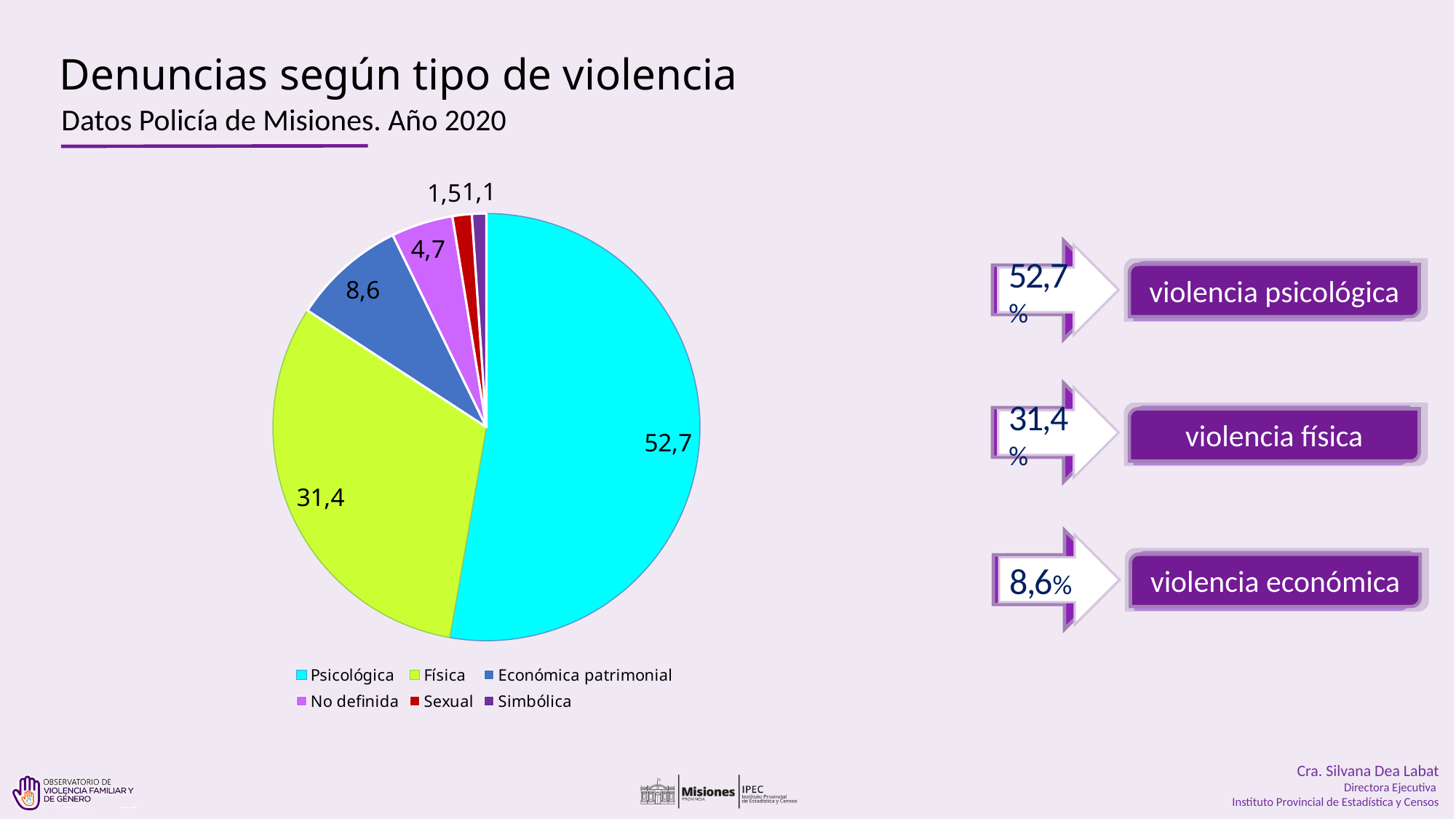
What is the value shown for No definida in the pie chart? 4,7 What is the value shown for Económica patrimonial in the pie chart? 8,6 How many categories does the pie chart legend list? 6 What colour is the Física slice in the pie chart? yellow-green Which is larger, the value for Económica patrimonial or the value for No definida? Económica patrimonial What is the title of the slide containing the pie chart? Denuncias según tipo de violencia What is the difference between the values for Psicológica and Física? 21,3 What is the value shown for Física in the pie chart? 31,4 What is the value shown for Psicológica in the pie chart? 52,7 What type of chart is shown on the slide? pie chart Which category has the largest slice of the pie chart? Psicológica Which category has the smallest slice of the pie chart? Simbólica